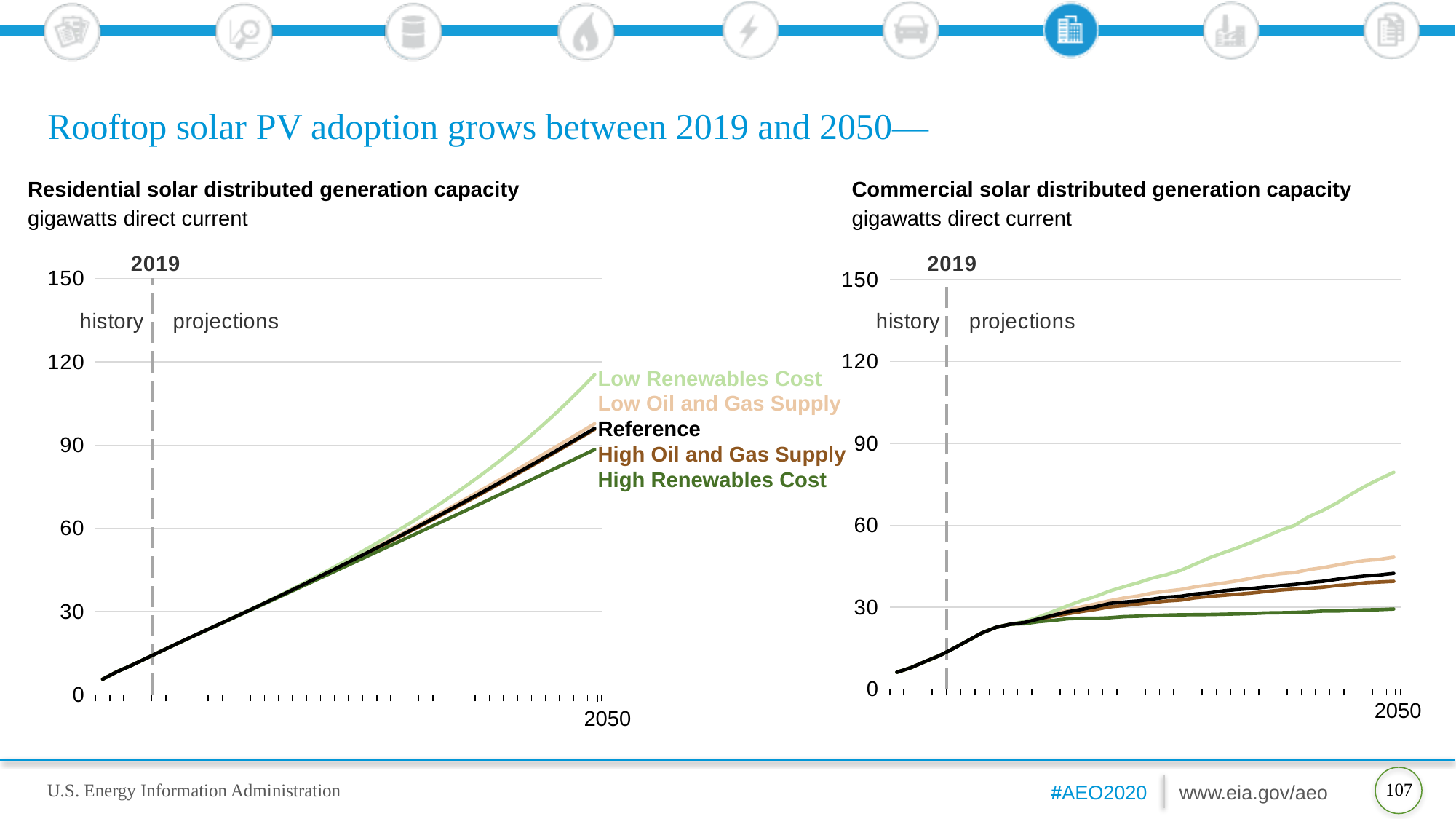
In the Residential solar distributed generation capacity chart, which series is highest in 2050? Low Renewables Cost How many series does the legend list for the Residential solar distributed generation capacity chart? 5 In the Residential solar distributed generation capacity chart, is the Low Renewables Cost value in 2050 greater or less than 90? greater What unit is shown under the title of the Commercial solar distributed generation capacity chart? gigawatts direct current In the Residential solar distributed generation capacity chart, do the projected values rise or fall from 2019 to 2050? rise In the Residential solar distributed generation capacity chart, which series is lowest in 2050? High Renewables Cost In the Commercial solar distributed generation capacity chart, is the Reference value in 2050 greater or less than 60? less In the Residential solar distributed generation capacity chart, is the Low Renewables Cost value in 2050 greater or less than 120? less In the Commercial solar distributed generation capacity chart, which series is lowest in 2050? High Renewables Cost What kind of chart is the Residential solar distributed generation capacity chart? line chart In the Commercial solar distributed generation capacity chart, which series is highest in 2050? Low Renewables Cost